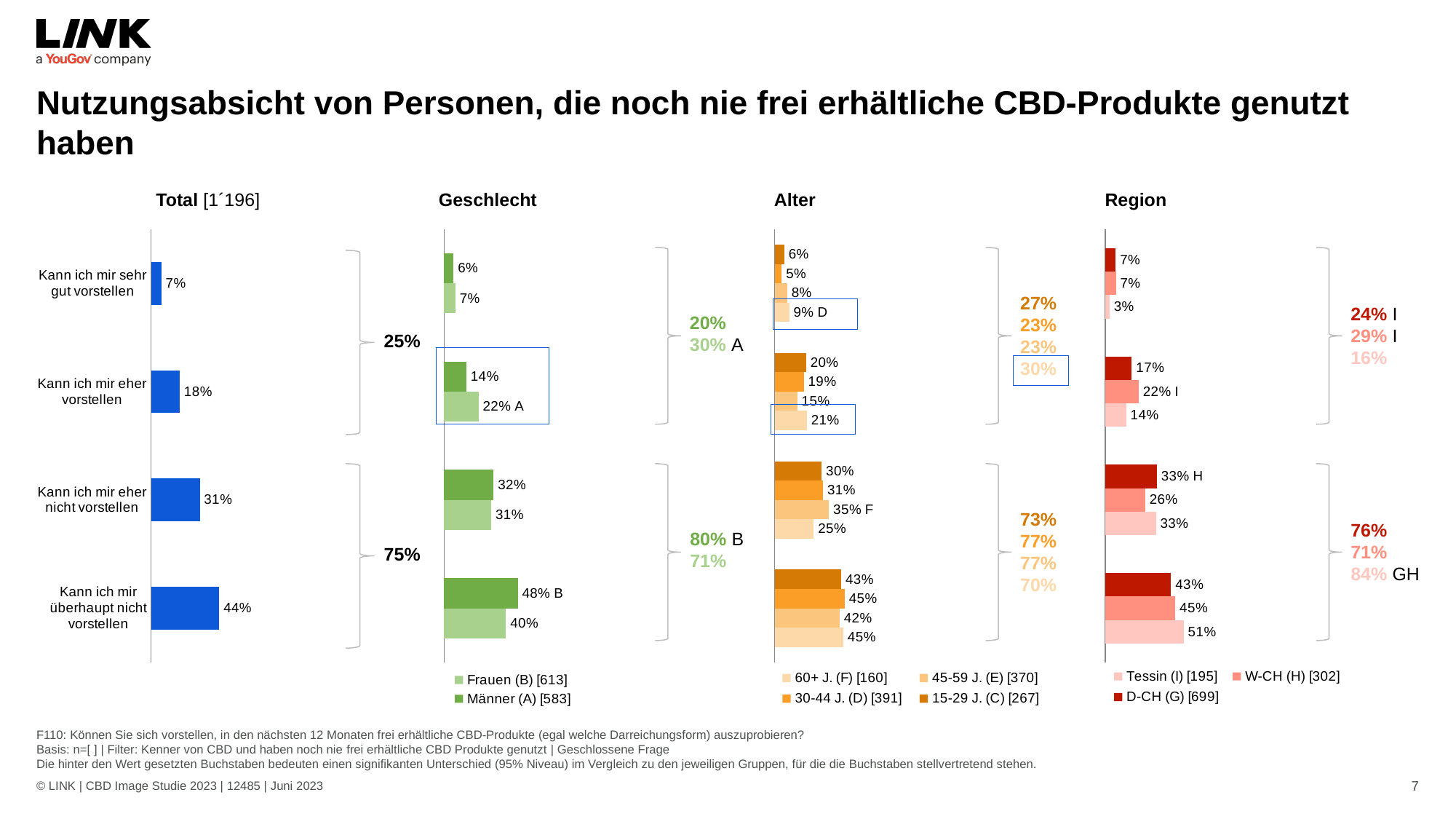
In the Alter chart, what is the value for 45-59 J. (E) for "Kann ich mir eher nicht vorstellen"? 35% In the Region chart, which region has the lowest value for "Kann ich mir sehr gut vorstellen"? Tessin (I) In the Total chart, what is the difference between "Kann ich mir eher nicht vorstellen" and "Kann ich mir eher vorstellen"? 13% In the Total chart, which category has the lowest value? Kann ich mir sehr gut vorstellen In the Total chart, how many categories are shown? 4 In the Geschlecht chart, which is larger for "Kann ich mir eher vorstellen": Frauen (B) or Männer (A)? Frauen (B) In the Geschlecht chart, how many series does the legend list? 2 In the Region chart, what is the value for Tessin (I) for "Kann ich mir überhaupt nicht vorstellen"? 51% What kind of chart is the Total chart? bar chart In the Geschlecht chart, what is the value for Männer (A) for "Kann ich mir überhaupt nicht vorstellen"? 48% In the Alter chart, how many series does the legend list? 4 In the Total chart, what is the value for "Kann ich mir überhaupt nicht vorstellen"? 44%